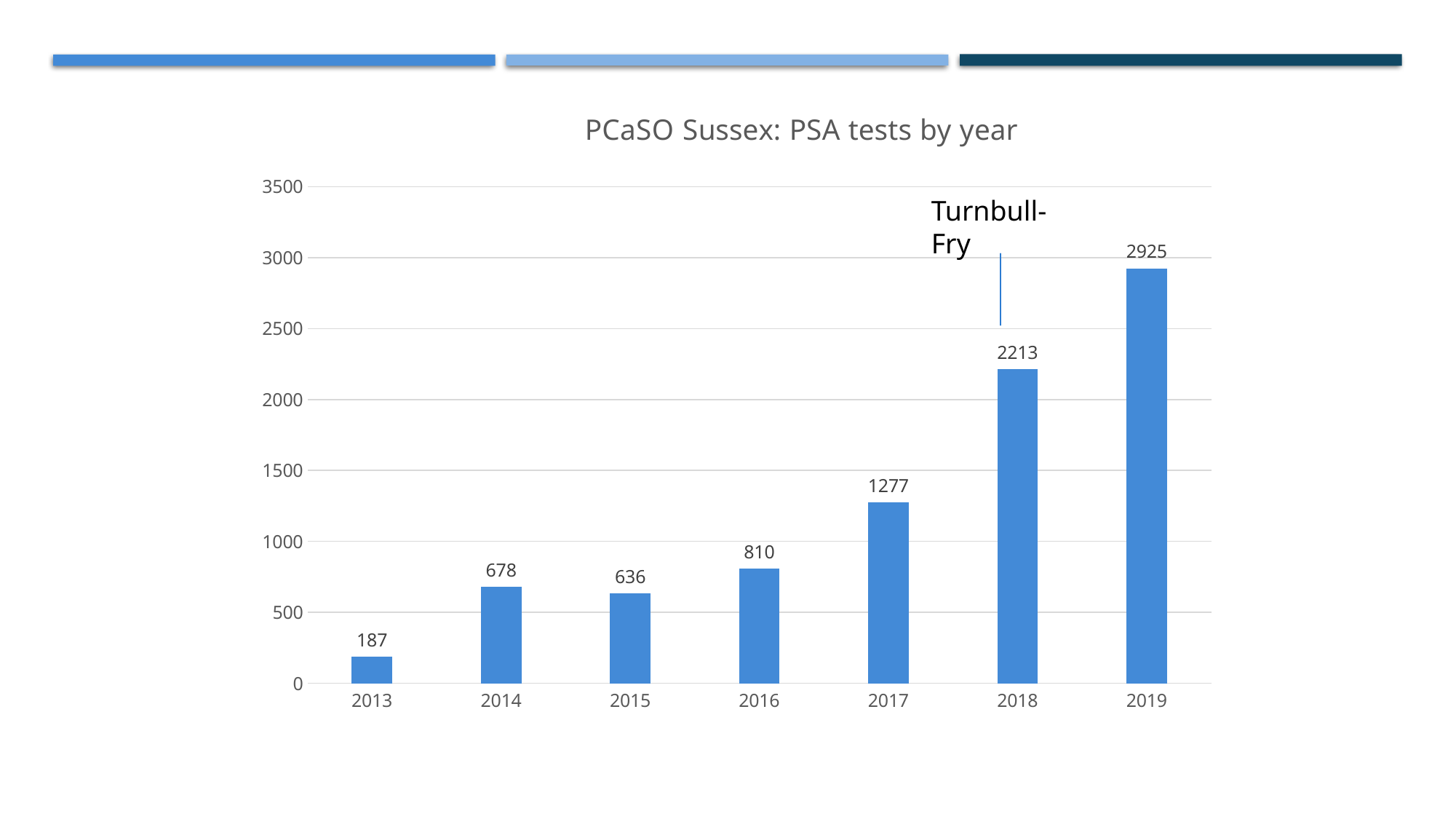
What is the difference between the values for 2019 and 2018? 712 Which year has the highest value? 2019 What kind of chart is this? bar chart Which is larger, the value for 2014 or the value for 2015? 2014 What is the value for 2013? 187 What is the value for 2017? 1277 What is the difference between the values for 2014 and 2015? 42 Is the value for 2016 greater or less than 1000? less Which year has the lowest value? 2013 What is the value for 2019? 2925 How many years are shown on the x axis? 7 What is the title of the chart? PCaSO Sussex: PSA tests by year